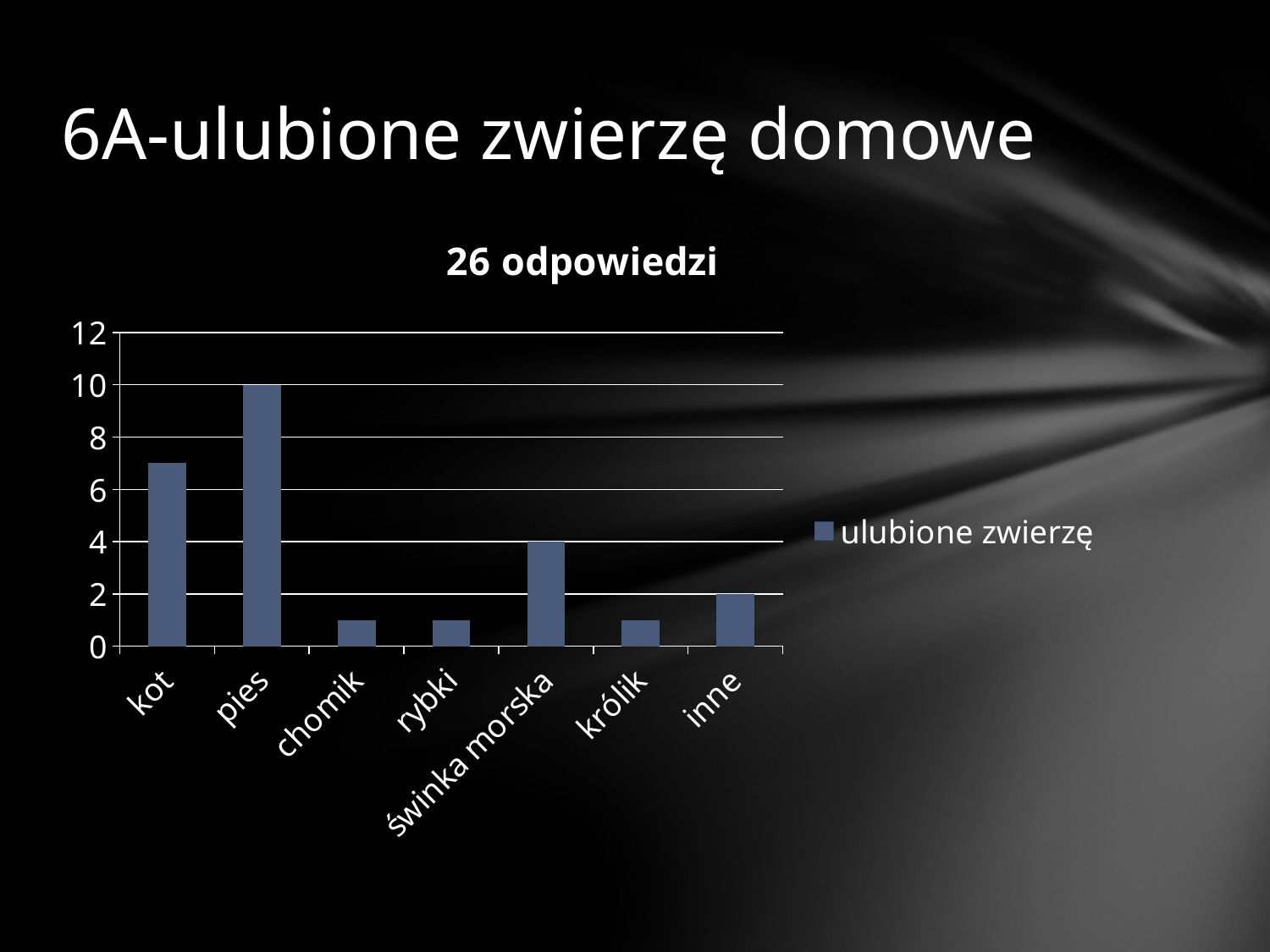
How many series does the legend list? 1 How many categories are shown on the x axis? 7 What is the title of the chart? 26 odpowiedzi Which category has the highest value? pies Is the value for chomik greater or less than 2? less Is the value for kot greater or less than 6? greater What type of chart is shown on the slide? bar chart Which is larger, the value for kot or the value for pies? pies What is the difference between the values for pies and świnka morska? 6 What is the value for inne? 2 What is the value for świnka morska? 4 What is the value for pies? 10